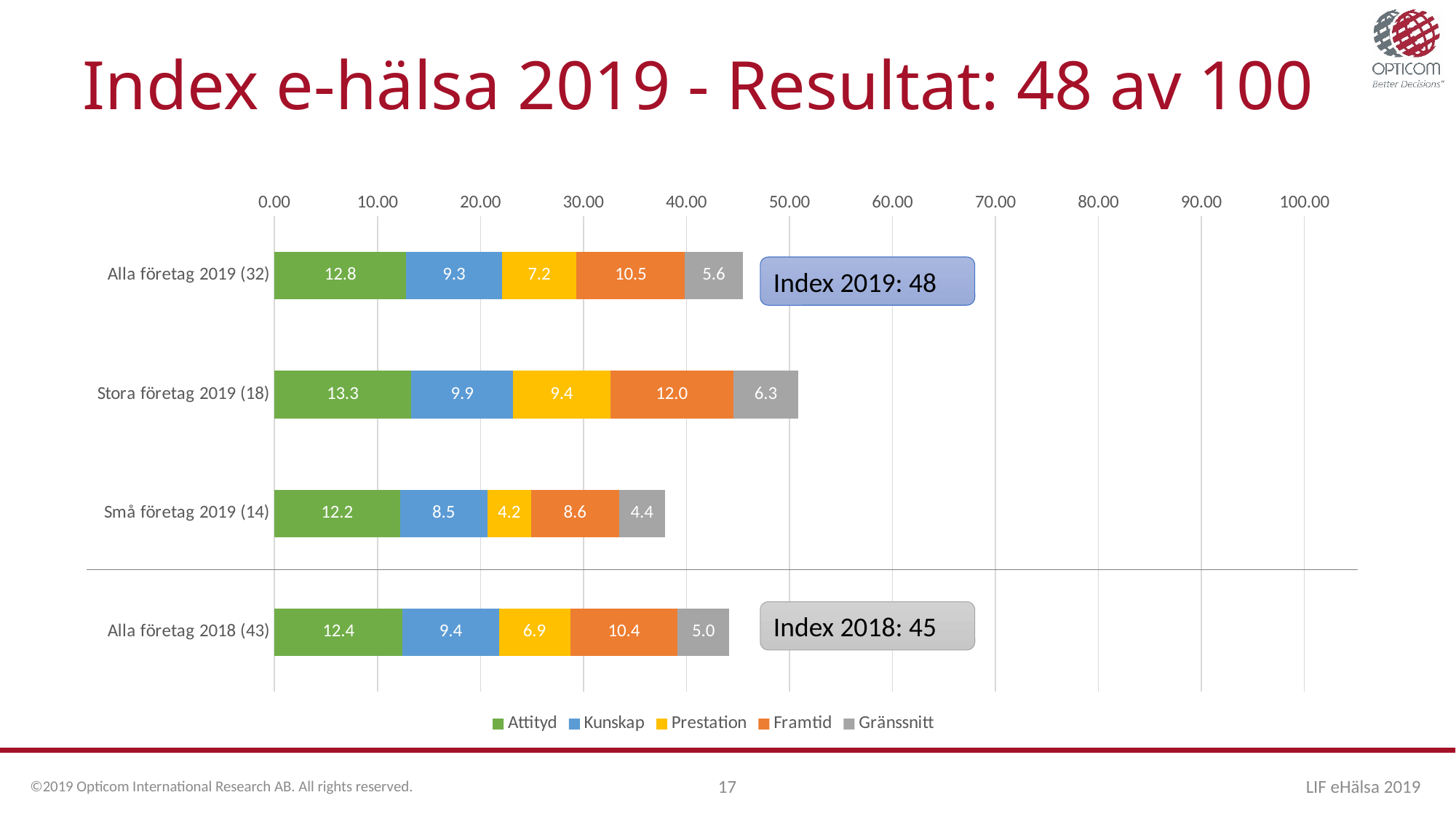
What is the difference between the Framtid values for Stora företag 2019 (18) and Små företag 2019 (14)? 3.4 How many categories are shown on the y axis? 4 What is the total of the stacked bar for Små företag 2019 (14)? 37.9 What kind of chart is shown on the slide? Stacked bar chart Which category has the lowest Kunskap value? Små företag 2019 (14) Which is larger, the Prestation value for Alla företag 2019 (32) or for Alla företag 2018 (43)? Alla företag 2019 (32) What is the Gränssnitt value for Alla företag 2018 (43)? 5.0 How many series does the legend list? 5 What is the Attityd value for Stora företag 2019 (18)? 13.3 What is the total of the stacked bar for Stora företag 2019 (18)? 50.9 What is the Prestation value for Små företag 2019 (14)? 4.2 Which category has the highest Framtid value? Stora företag 2019 (18)